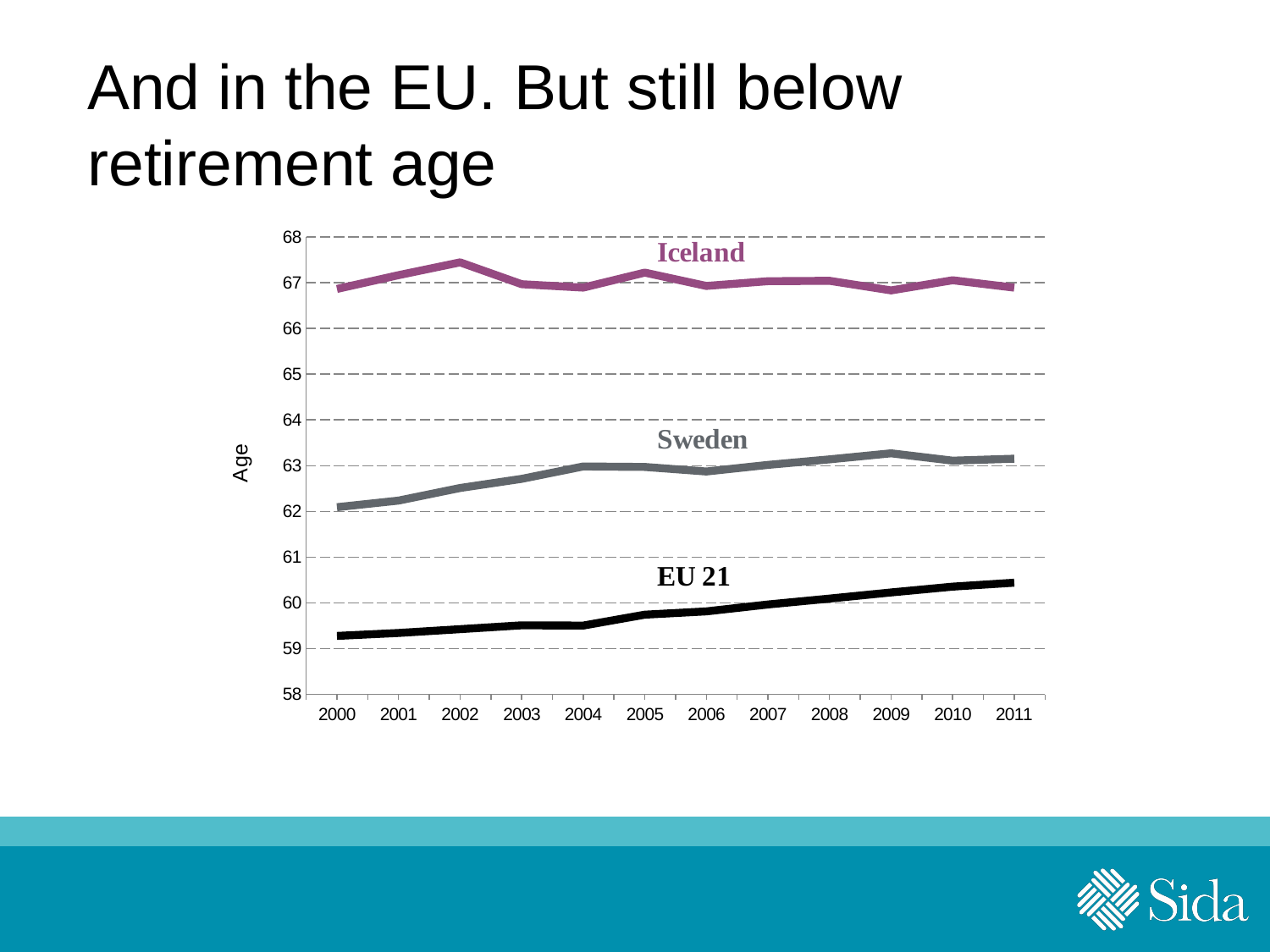
Is the value for EU 21 in 2011 greater or less than 60? greater Which series has the lowest values throughout the chart? EU 21 Which series has the highest values throughout the chart? Iceland How many series are plotted on the chart? 3 Is the value for EU 21 in 2000 greater or less than 60? less How many years are shown along the x axis? 12 What kind of chart is shown on the slide? Line chart Which is larger in 2005, the value for Sweden or the value for EU 21? Sweden What is the label on the y axis? Age Is the value for Sweden in 2009 greater or less than 63? greater Does the EU 21 line rise or fall from 2000 to 2011? rise